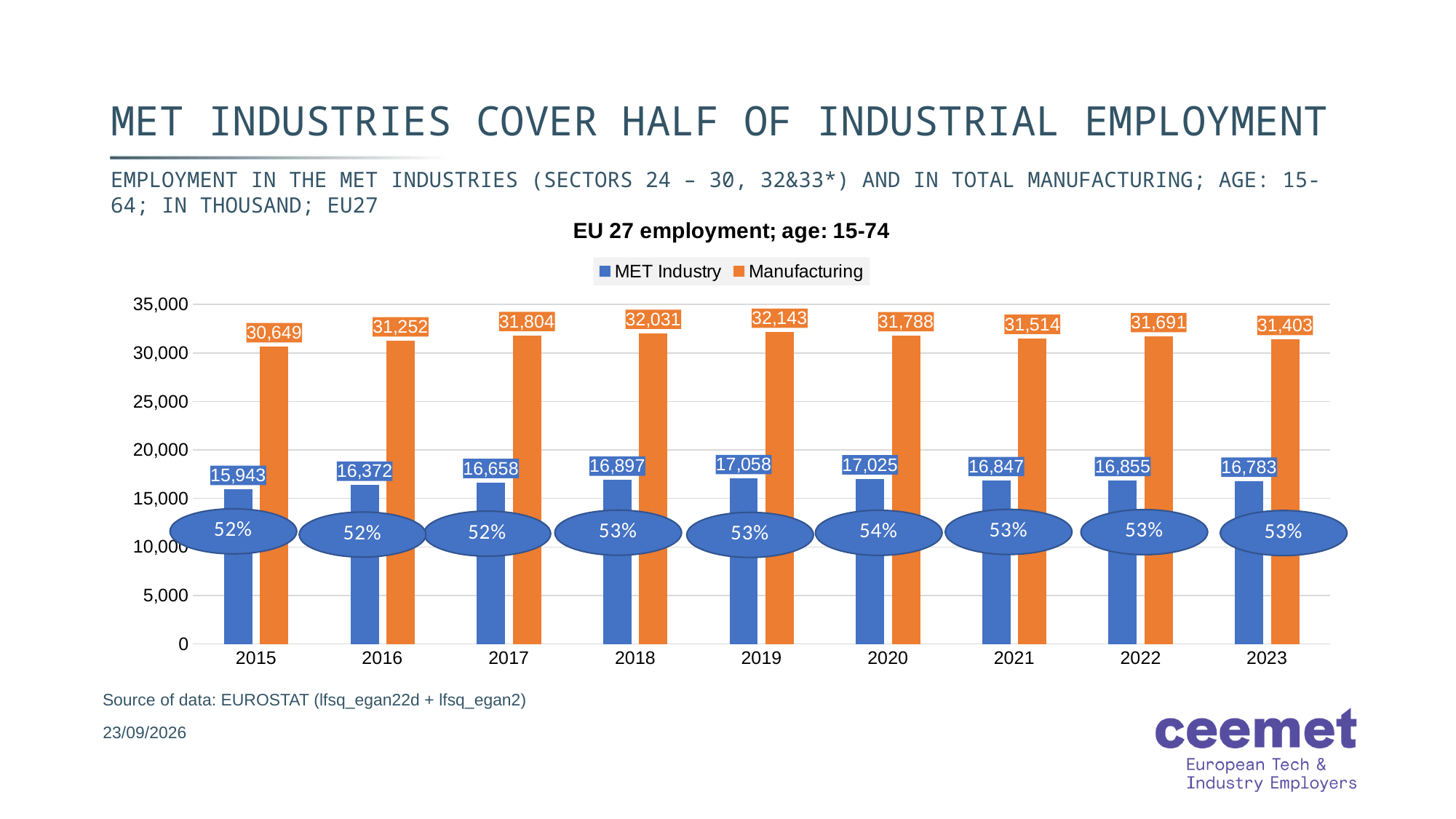
How many series does the legend list? 2 In which year is Manufacturing employment highest? 2019 Does MET Industry employment rise or fall from 2015 to 2019? rise What is the difference between Manufacturing and MET Industry employment in 2023? 14,620 What is the MET Industry employment value for 2019? 17,058 What kind of chart is shown on the slide? bar chart What is the title of the chart? EU 27 employment; age: 15-74 How many years are shown on the x axis? 9 Which is larger: MET Industry employment in 2020 or in 2021? 2020 What is the Manufacturing employment value for 2015? 30,649 Is the Manufacturing value for 2018 greater or less than 30,000? greater In which year is MET Industry employment lowest? 2015